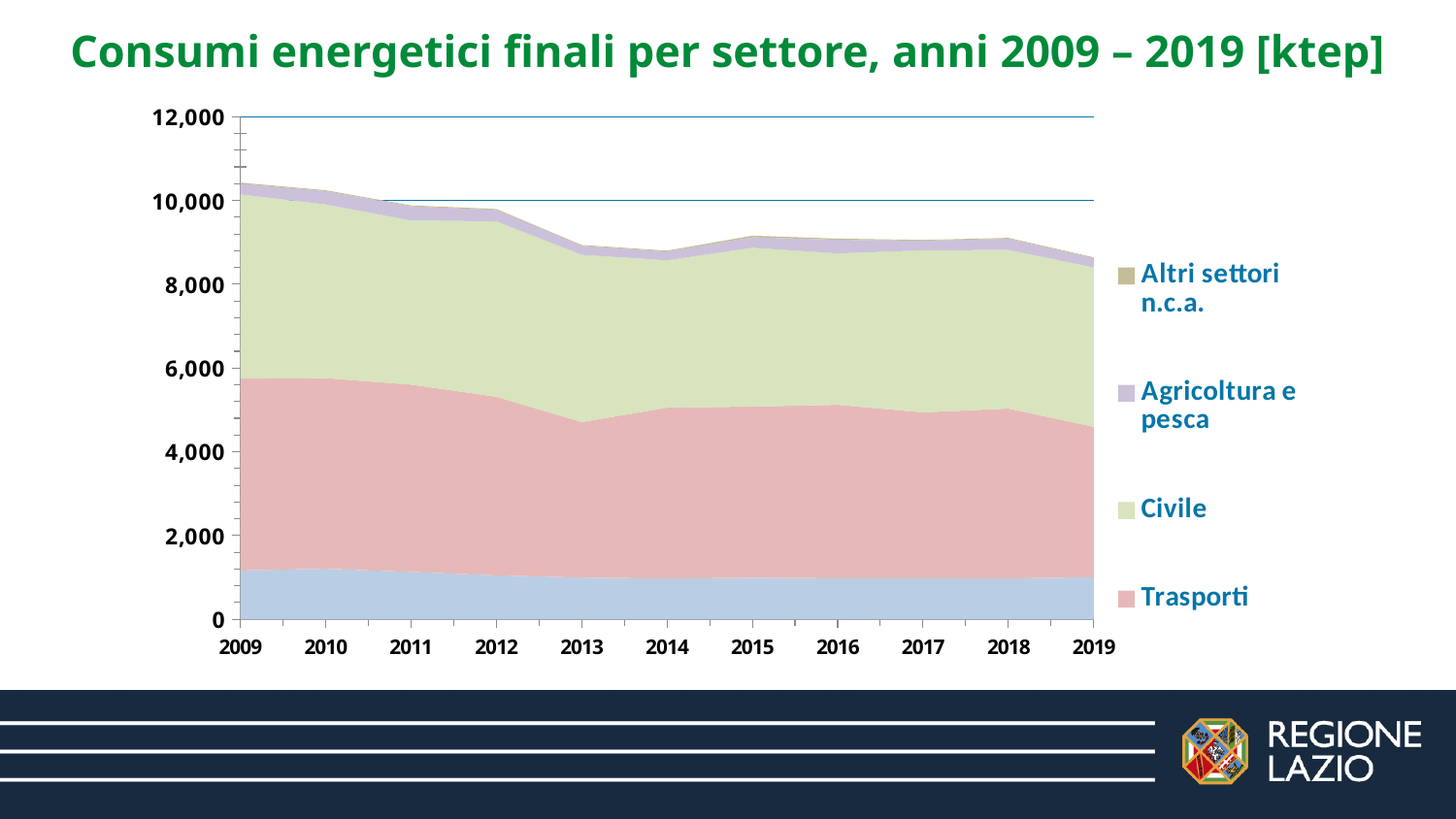
What is the title of the chart? Consumi energetici finali per settore, anni 2009 – 2019 [ktep] Is the total stacked value for 2013 greater or less than 10,000? less Is the total stacked value for 2019 greater or less than 10,000? less What kind of chart is shown on the slide? Stacked area chart Does the total stacked value rise or fall from 2009 to 2019? fall Is the total stacked value for 2019 greater or less than 8,000? greater Which legend entry is shown in green? Civile In which year is the total stacked value highest? 2009 In which year is the total stacked value lowest? 2019 How many years are plotted along the x axis? 11 How many series does the legend list? 4